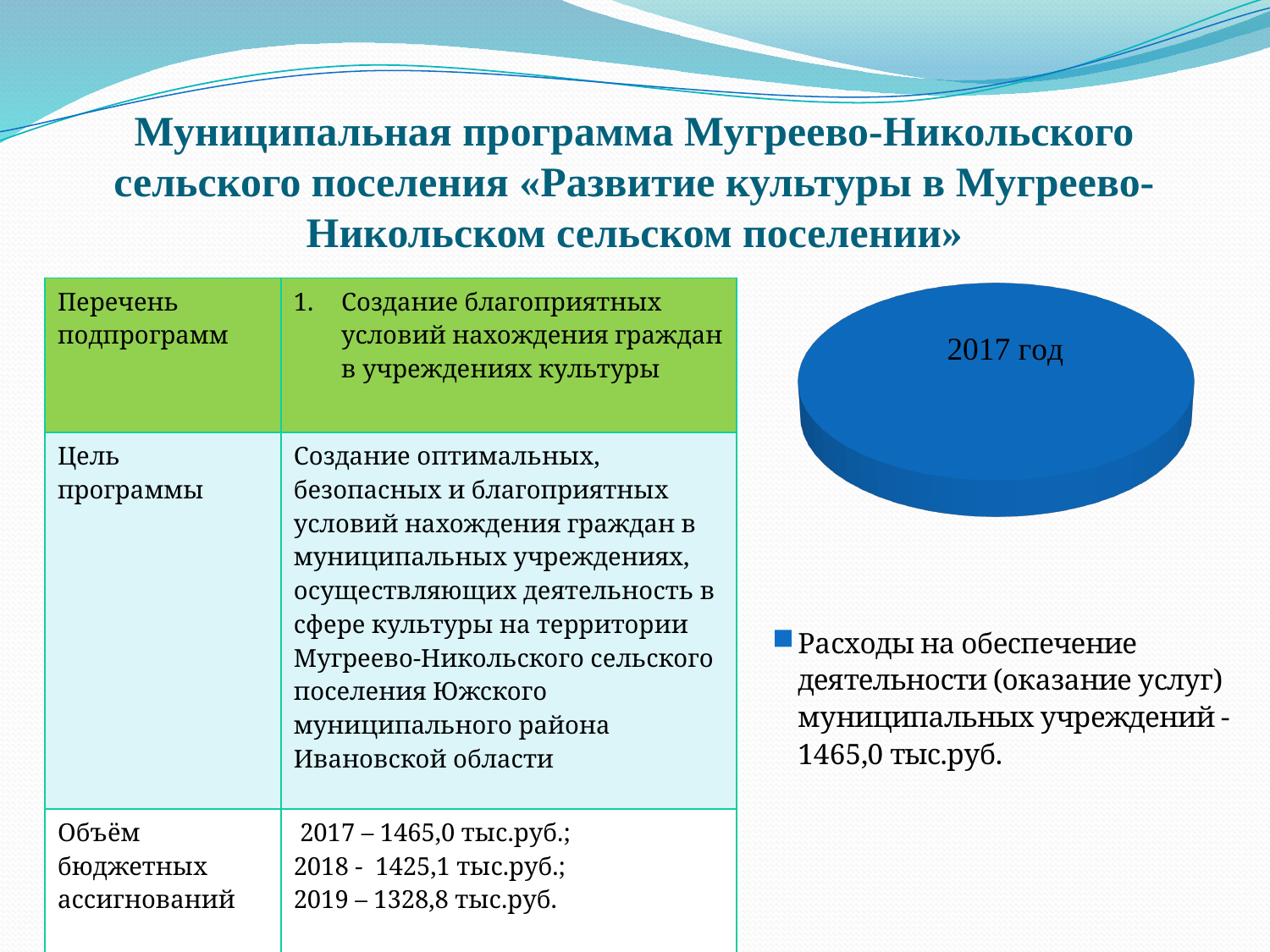
What colour is the slice of the pie chart? blue According to the chart legend, what is the value of 'Расходы на обеспечение деятельности (оказание услуг) муниципальных учреждений'? 1465,0 тыс.руб. How many entries does the legend of the pie chart list? 1 What kind of chart is shown on the right side of the slide? pie chart How many slices does the pie chart contain? 1 What title is shown on the pie chart? 2017 год What share of the pie chart does the slice for 'Расходы на обеспечение деятельности (оказание услуг) муниципальных учреждений' represent? 100%